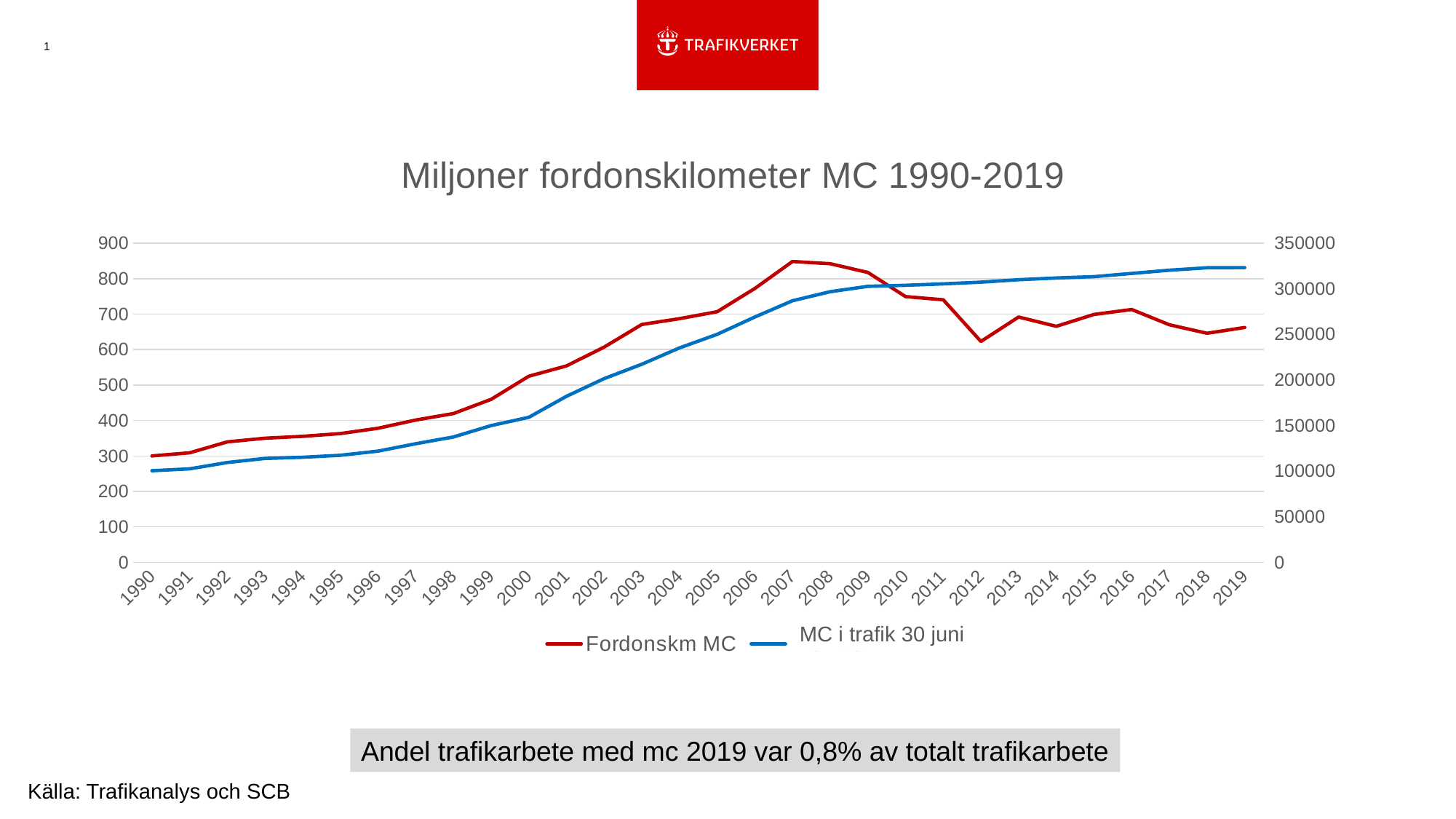
Is the value for MC i trafik 30 juni in 2019 greater or less than 300000? greater Which is larger for Fordonskm MC: the value in 2007 or the value in 2012? 2007 What kind of chart is shown on the slide? Line chart Is the value for Fordonskm MC in 2012 greater or less than 700? less Is the value for Fordonskm MC in 2007 greater or less than 800? greater In which year is the MC i trafik 30 juni series at its lowest? 1990 How many years are plotted along the x axis? 30 Which series is drawn in blue? MC i trafik 30 juni In which year does the Fordonskm MC series reach its highest value? 2007 How many series does the legend list? 2 What is the title of the chart? Miljoner fordonskilometer MC 1990-2019 Does the MC i trafik 30 juni series generally rise or fall from 1990 to 2019? Rise